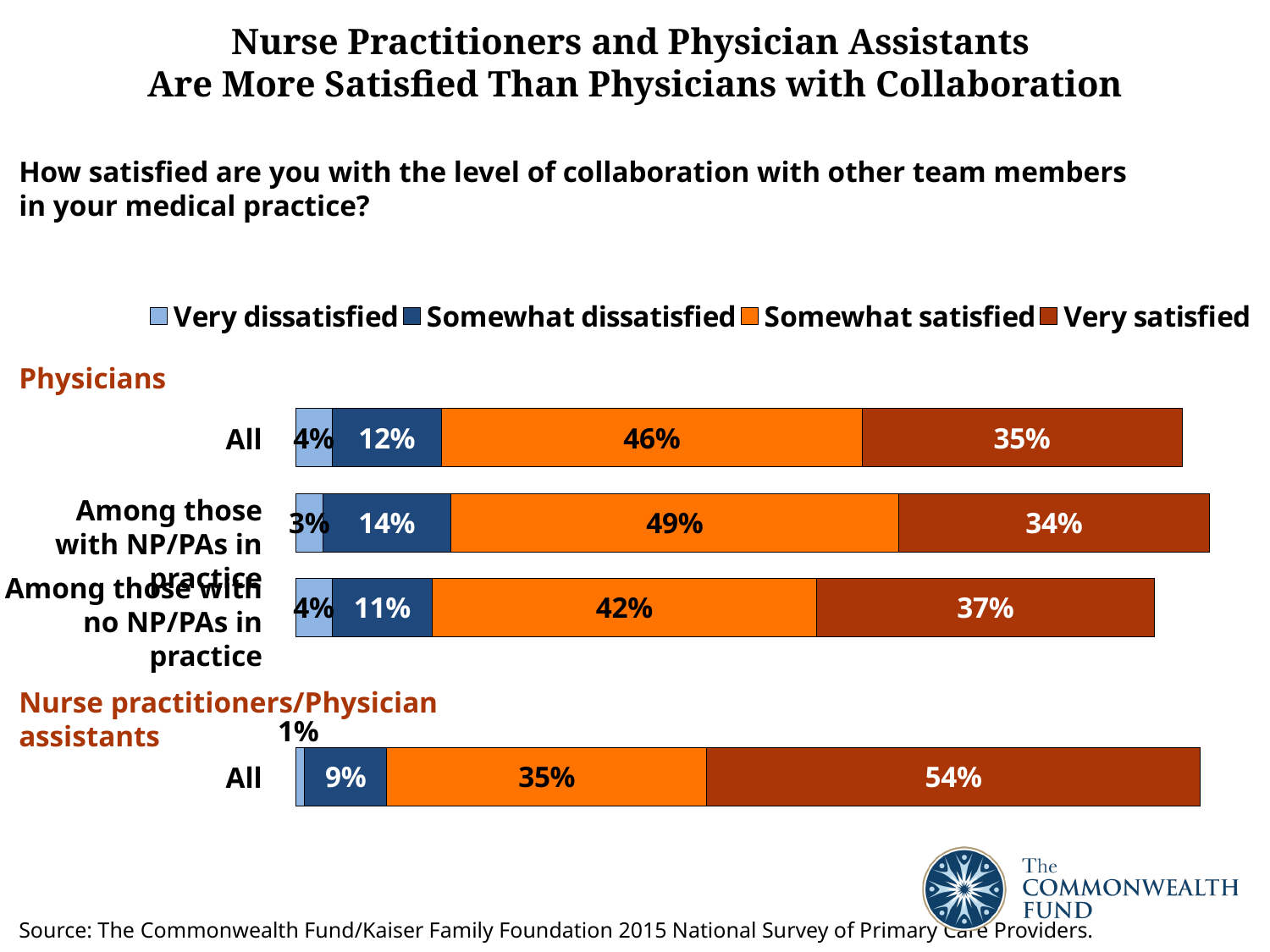
What percentage of all nurse practitioners/physician assistants are very satisfied? 54% What is the difference between the very satisfied share for all nurse practitioners/physician assistants and for all physicians? 19 percentage points What percentage of all nurse practitioners/physician assistants are very dissatisfied? 1% Which group has the highest share of very satisfied respondents? Nurse practitioners/Physician assistants (All) What kind of chart is shown on the slide? Stacked bar chart Which group has the lowest share of very dissatisfied respondents? Nurse practitioners/Physician assistants (All) How many series does the legend list? 4 Which is larger: the somewhat satisfied share for all physicians or for all nurse practitioners/physician assistants? All physicians What is the total of the somewhat satisfied and very satisfied shares for physicians with no NP/PAs in practice? 79% What percentage of all physicians are very satisfied with the level of collaboration? 35% What percentage of physicians with NP/PAs in practice are somewhat satisfied? 49% What percentage of physicians with no NP/PAs in practice are somewhat dissatisfied? 11%